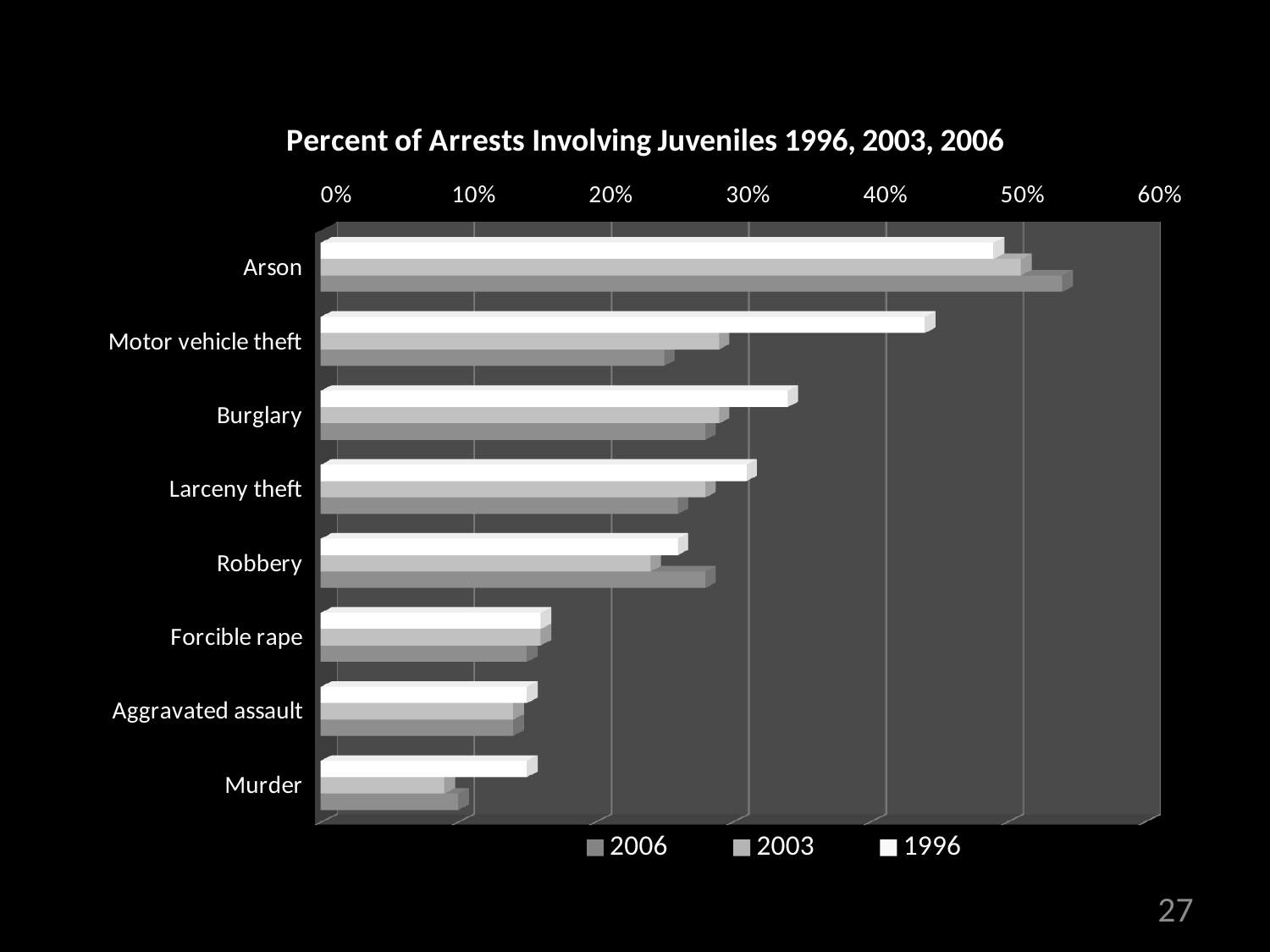
Is the 1996 value for Burglary greater or less than 30%? greater What kind of chart is shown on the slide? Bar chart Which offense category has the lowest percent of arrests involving juveniles in 2003? Murder Is the 2006 value for Arson greater or less than 50%? greater Is the 1996 value for Motor vehicle theft greater or less than 40%? greater For Motor vehicle theft, which year has the larger value, 1996 or 2006? 1996 What is the title of the chart? Percent of Arrests Involving Juveniles 1996, 2003, 2006 How many offense categories are shown on the chart? 8 Which offense category has the highest percent of arrests involving juveniles in 1996? Arson How many series does the legend list? 3 For Arson, which year has the larger value, 1996 or 2006? 2006